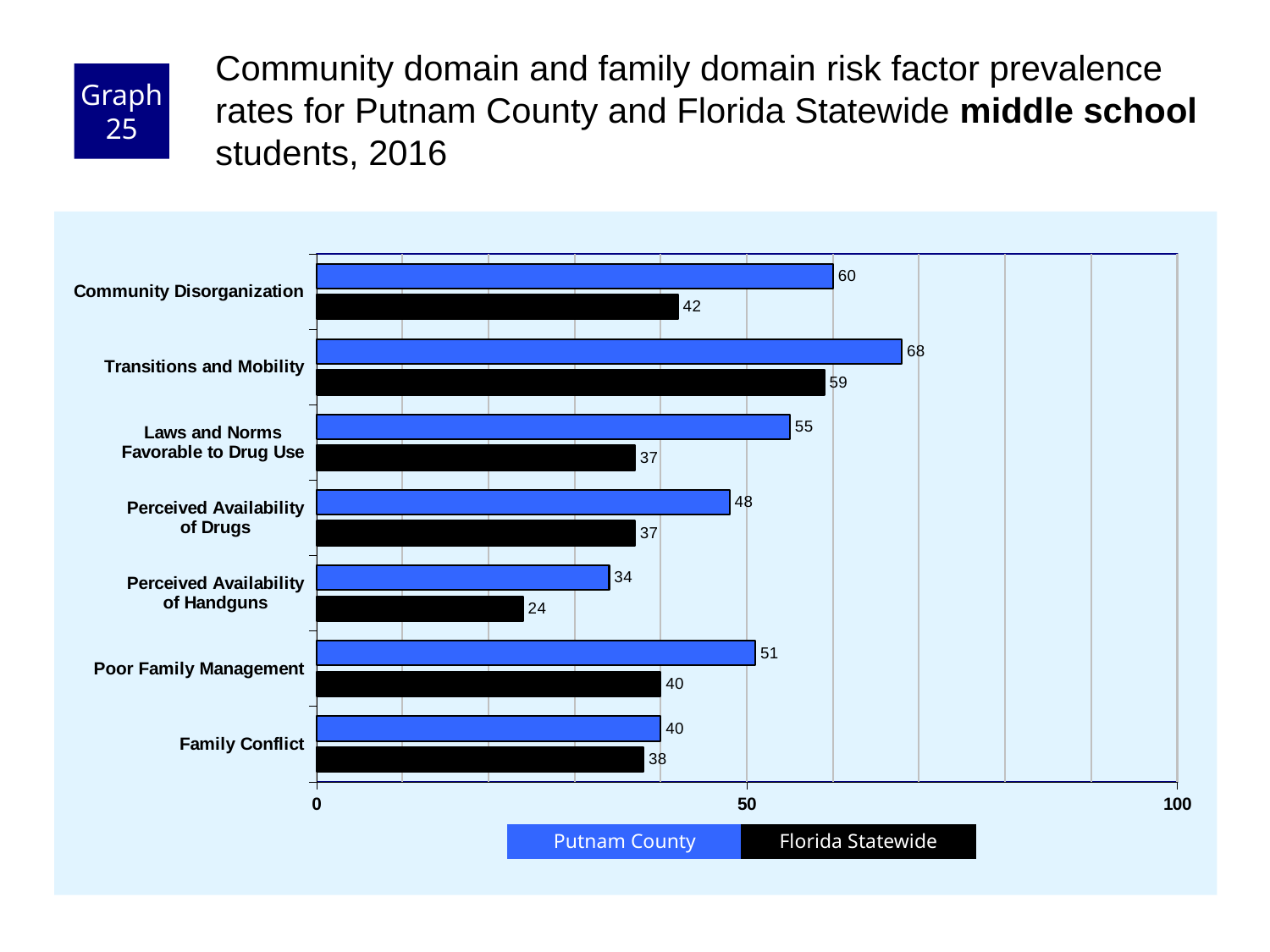
What kind of chart is shown on the slide? bar chart What is the difference between the Putnam County and Florida Statewide values for Laws and Norms Favorable to Drug Use? 18 What is the Putnam County value for Community Disorganization? 60 Which risk factor has the lowest Florida Statewide value? Perceived Availability of Handguns What is the Florida Statewide value for Perceived Availability of Handguns? 24 What is the Florida Statewide value for Transitions and Mobility? 59 Which risk factor has the highest Putnam County value? Transitions and Mobility Is the Putnam County value for Perceived Availability of Drugs greater or less than 50? less Which is larger for Poor Family Management: the Putnam County value or the Florida Statewide value? Putnam County Which colour represents Florida Statewide in the chart? black How many risk factor categories are shown on the chart? 7 How many series does the legend list? 2